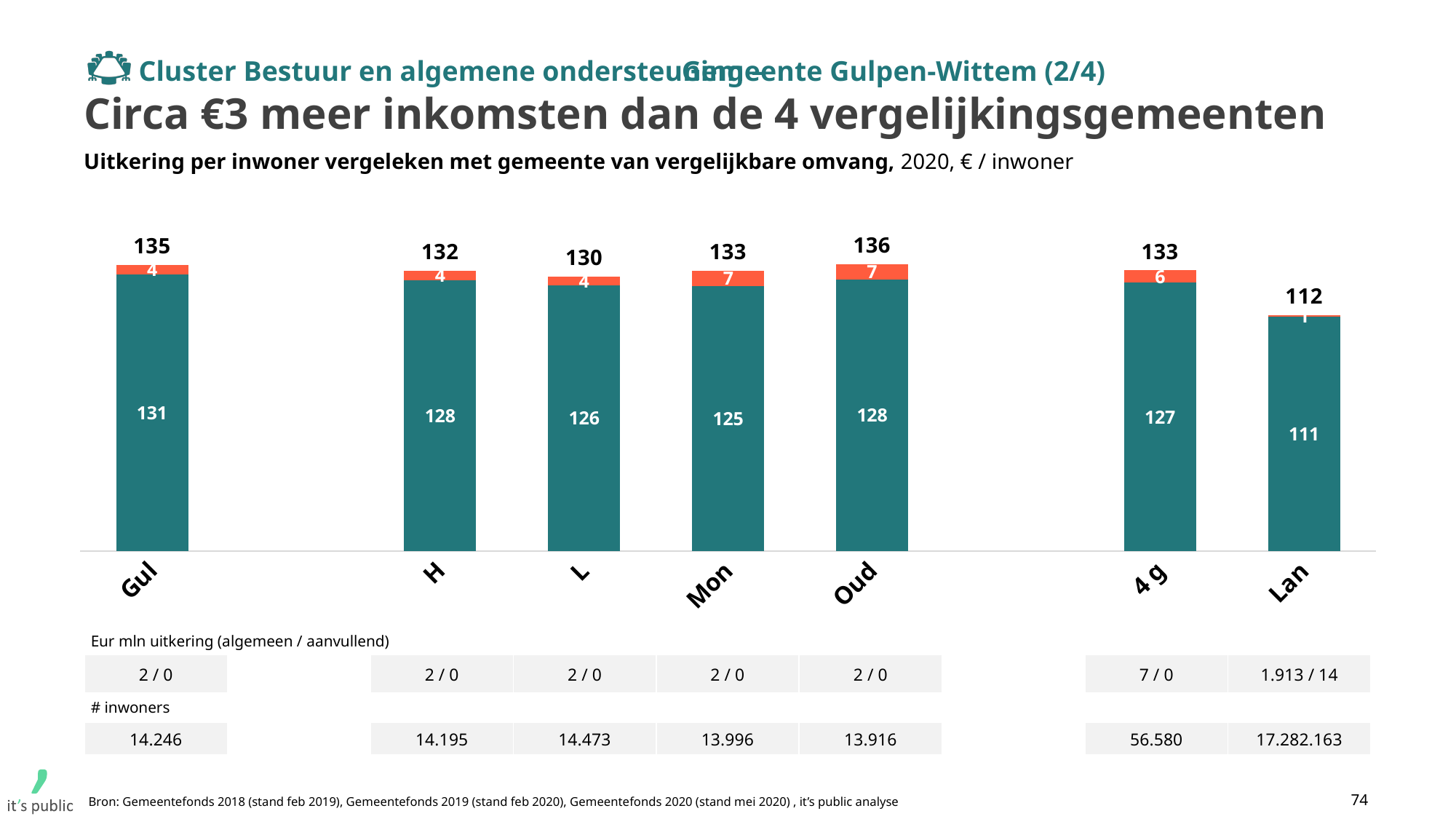
What is the total of the stacked bar for 4 g? 133 How many categories are shown on the x axis? 7 Which category has the highest total value? Oud What is the difference between the total for Gul and the total for Lan? 23 What is the value of the teal (lower) segment for Mon? 125 What kind of chart is shown on the slide? Stacked bar chart What is the value of the orange (upper) segment for Oud? 7 What unit is stated in the chart subtitle for the values? € / inwoner Which has a larger total value, H or L? H What is the total value of the bar for Gul? 135 Which category has the lowest total value? Lan What is the value of the teal (lower) segment for Lan? 111